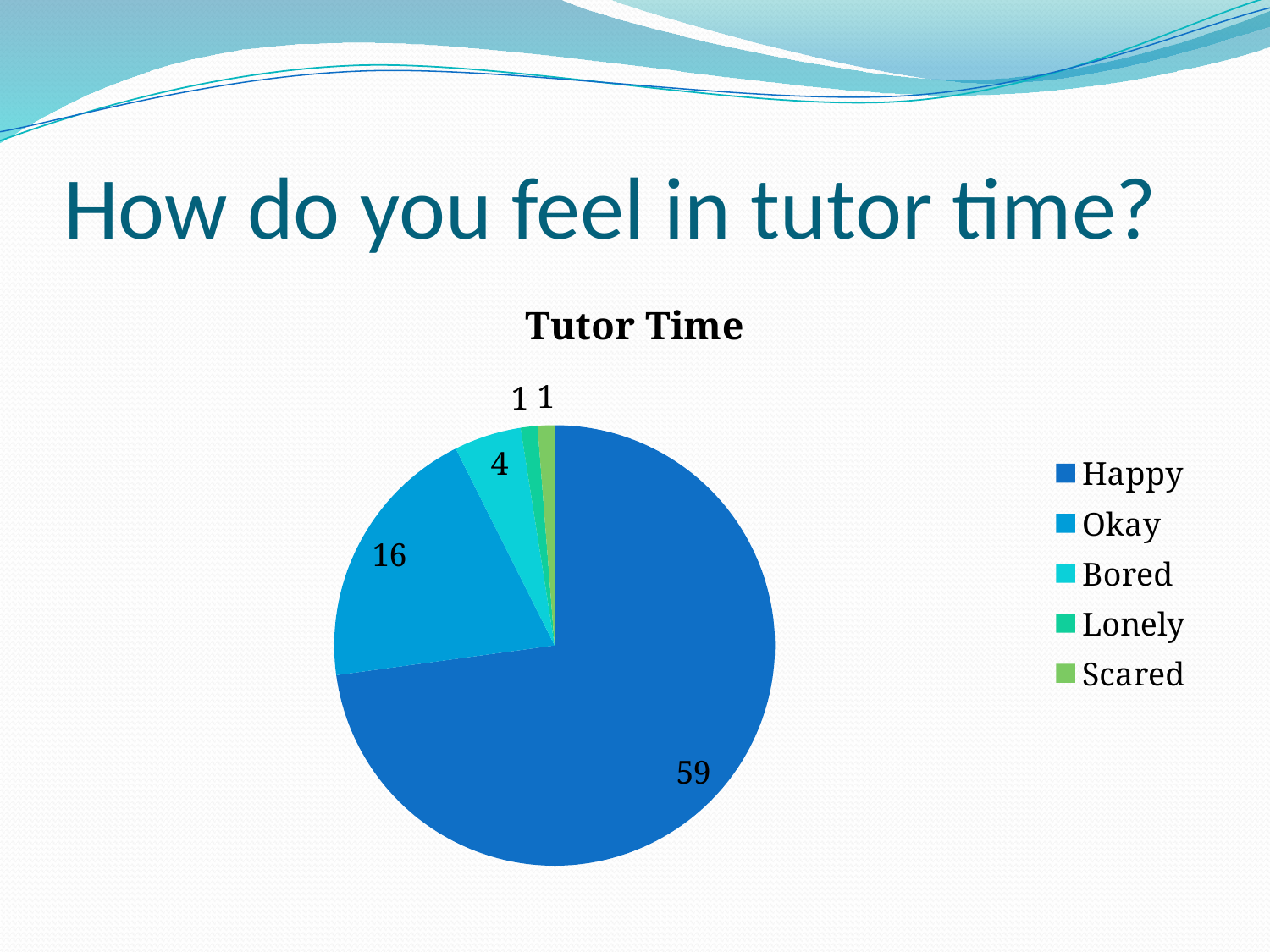
What is the value for Bored? 4 Which category has the largest slice? Happy What type of chart is shown on the slide? pie chart What is the total of all the values in the pie chart? 81 How many categories does the legend list? 5 Which is larger, the value for Okay or the value for Bored? Okay What is the difference between the values for Happy and Okay? 43 What is the title of the chart? Tutor Time What is the value for Okay? 16 Which legend entry is shown in green? Scared What is the value for Lonely? 1 What is the value for Happy? 59